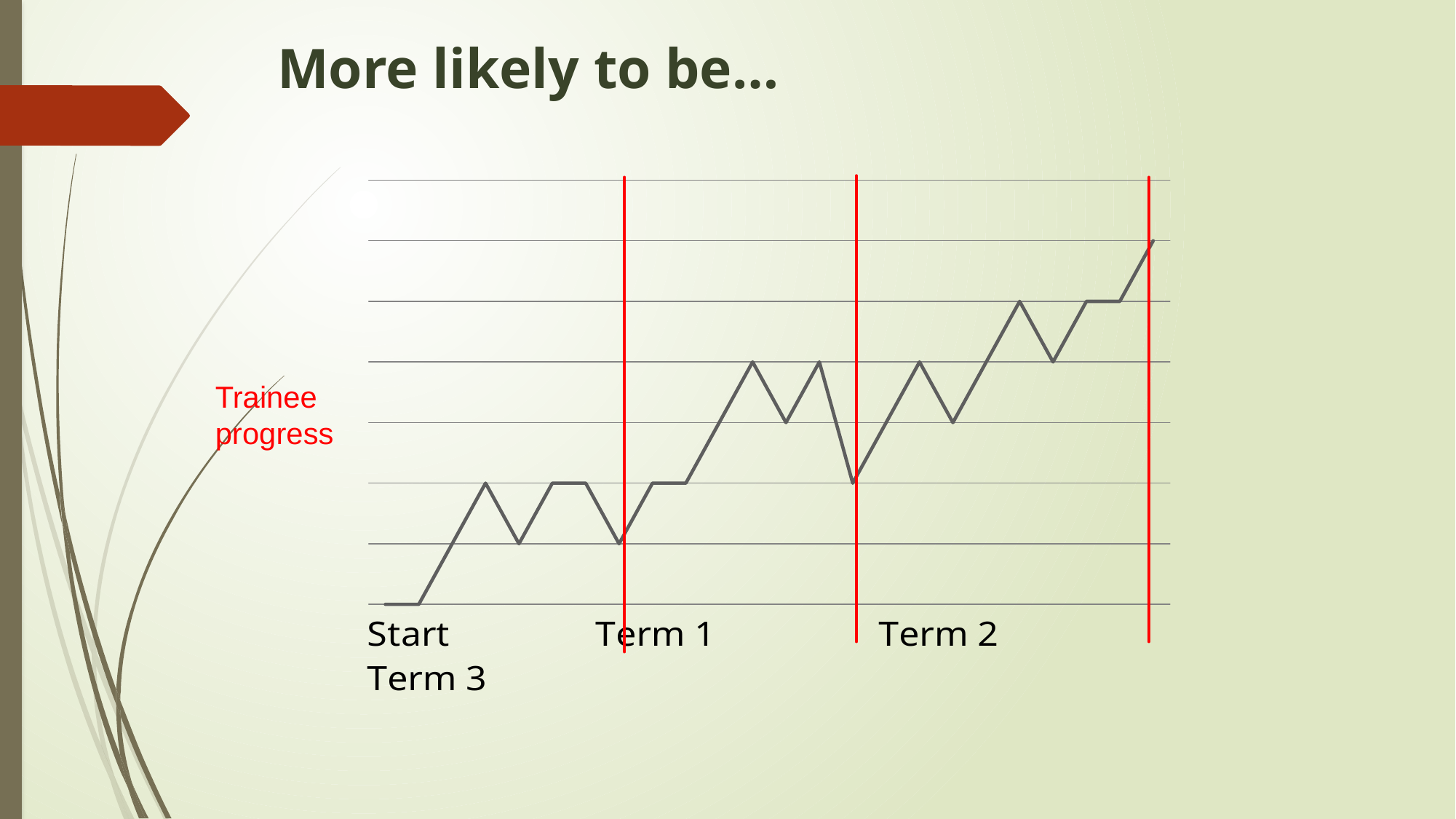
At which point on the x axis does the line reach its highest value? end of Term 3 At which point on the x axis is the line at its lowest value? Start Is the line at the end of Term 3 higher or lower than at Start? higher Does trainee progress generally rise or fall from Start to the end of Term 3? rise What is the label on the vertical axis of the chart? Trainee progress What is the title of the slide containing the chart? More likely to be… Is trainee progress at the end of Term 2 higher or lower than at the end of Term 1? higher What kind of chart is shown on the slide? line chart Is trainee progress at the end of Term 3 higher or lower than at the end of Term 1? higher How many red vertical lines mark term boundaries on the chart? 3